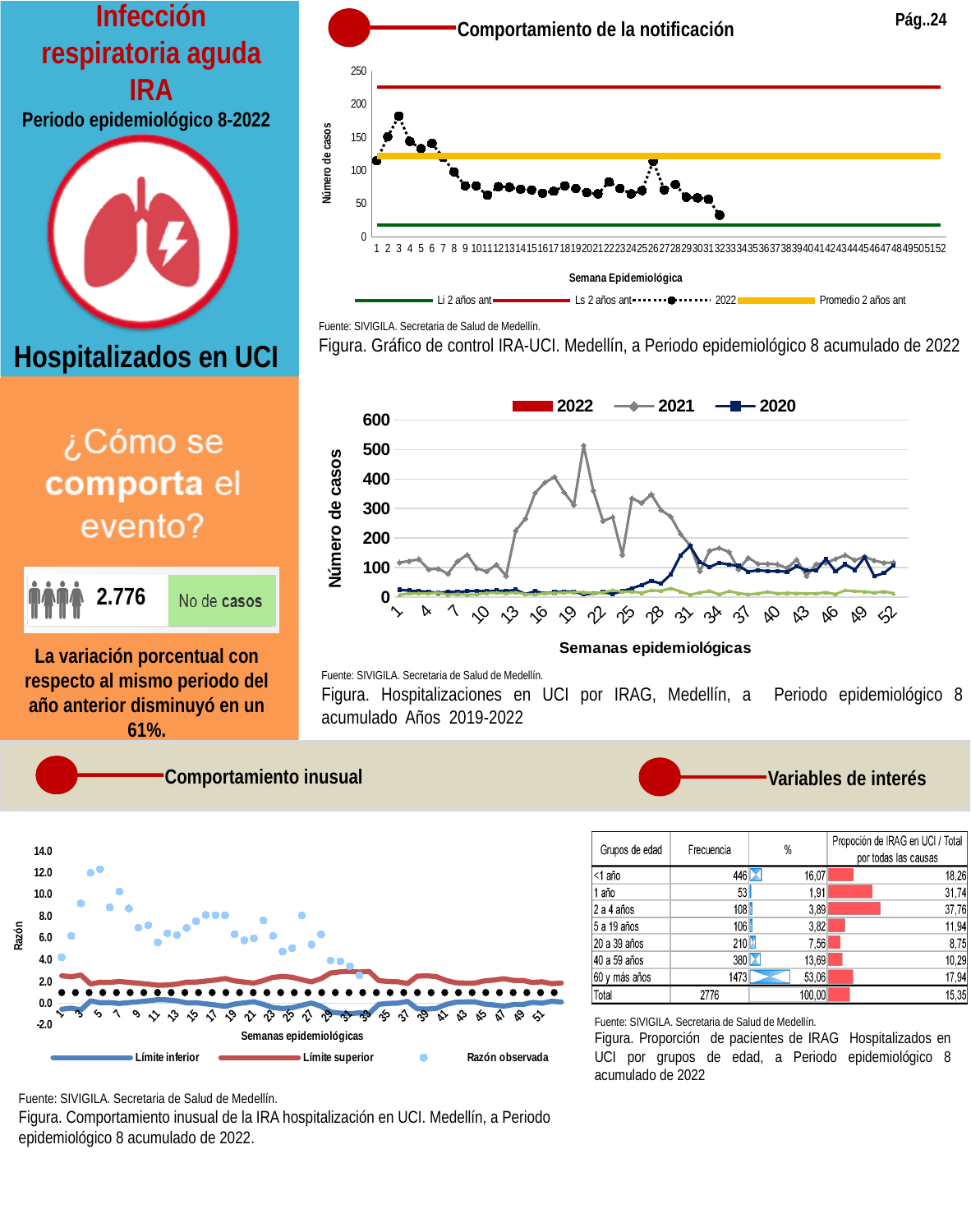
In the 'Hospitalizaciones en UCI por IRAG' chart, is the 2020 value at week 31 greater or less than 200? less In the 'Gráfico de control IRA-UCI' chart at the top, is the 'Ls 2 años ant' line greater or less than 200? greater In the 'Hospitalizaciones en UCI por IRAG' chart, is the 2021 value at week 19 greater or less than 400? less In the 'Comportamiento inusual' chart at the bottom left, how many series does the legend list? 3 In the table of IRAG patients hospitalized in UCI by age group at the bottom right, what is the Frecuencia for '60 y más años'? 1473 In the table of IRAG patients hospitalized in UCI by age group at the bottom right, which age group has the highest 'Proporción de IRAG en UCI / Total por todas las causas'? 2 a 4 años In the 'Gráfico de control IRA-UCI' chart at the top, how many series does the legend list? 4 In the 'Hospitalizaciones en UCI por IRAG' chart, what kind of chart is it? combination bar and line chart In the 'Hospitalizaciones en UCI por IRAG' chart, how many series does the legend list? 3